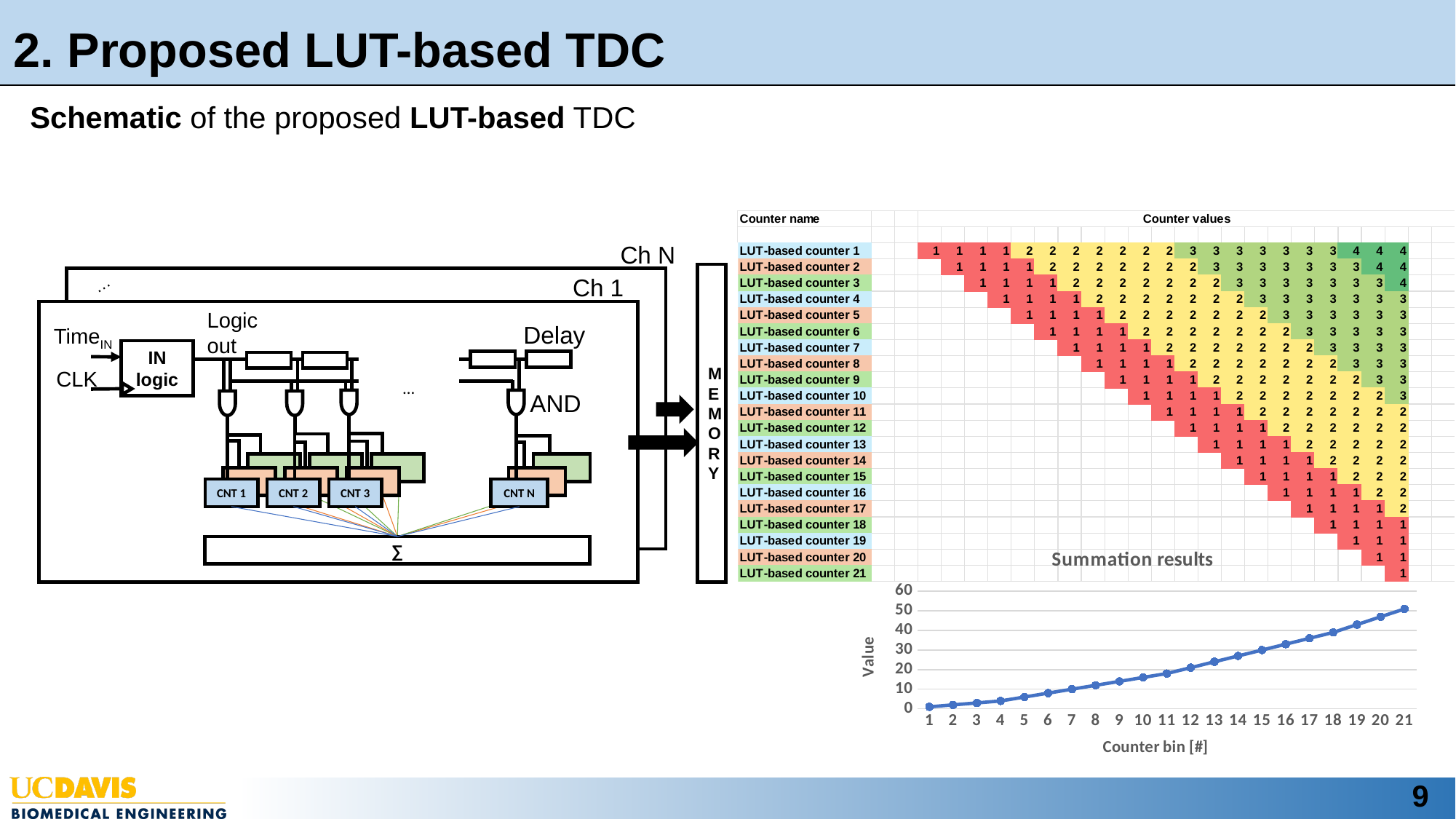
What is the x-axis title of the "Summation results" chart? Counter bin [#] In the "Summation results" chart, is the value for counter bin 1 greater or less than 10? less In the "Summation results" chart, is the value for counter bin 10 greater or less than 10? greater In the "Summation results" chart, is the value for counter bin 20 greater or less than 50? less In the "Summation results" chart, do the values rise or fall as the counter bin number increases? rise In the "Summation results" chart, which counter bin has the highest value? 21 In the "Summation results" chart, which counter bin has the lowest value? 1 In the "Summation results" chart, which has the larger value, counter bin 5 or counter bin 17? counter bin 17 In the "Summation results" chart, how many counter bins are plotted along the x axis? 21 What kind of chart is the "Summation results" chart? line chart What is the y-axis title of the "Summation results" chart? Value